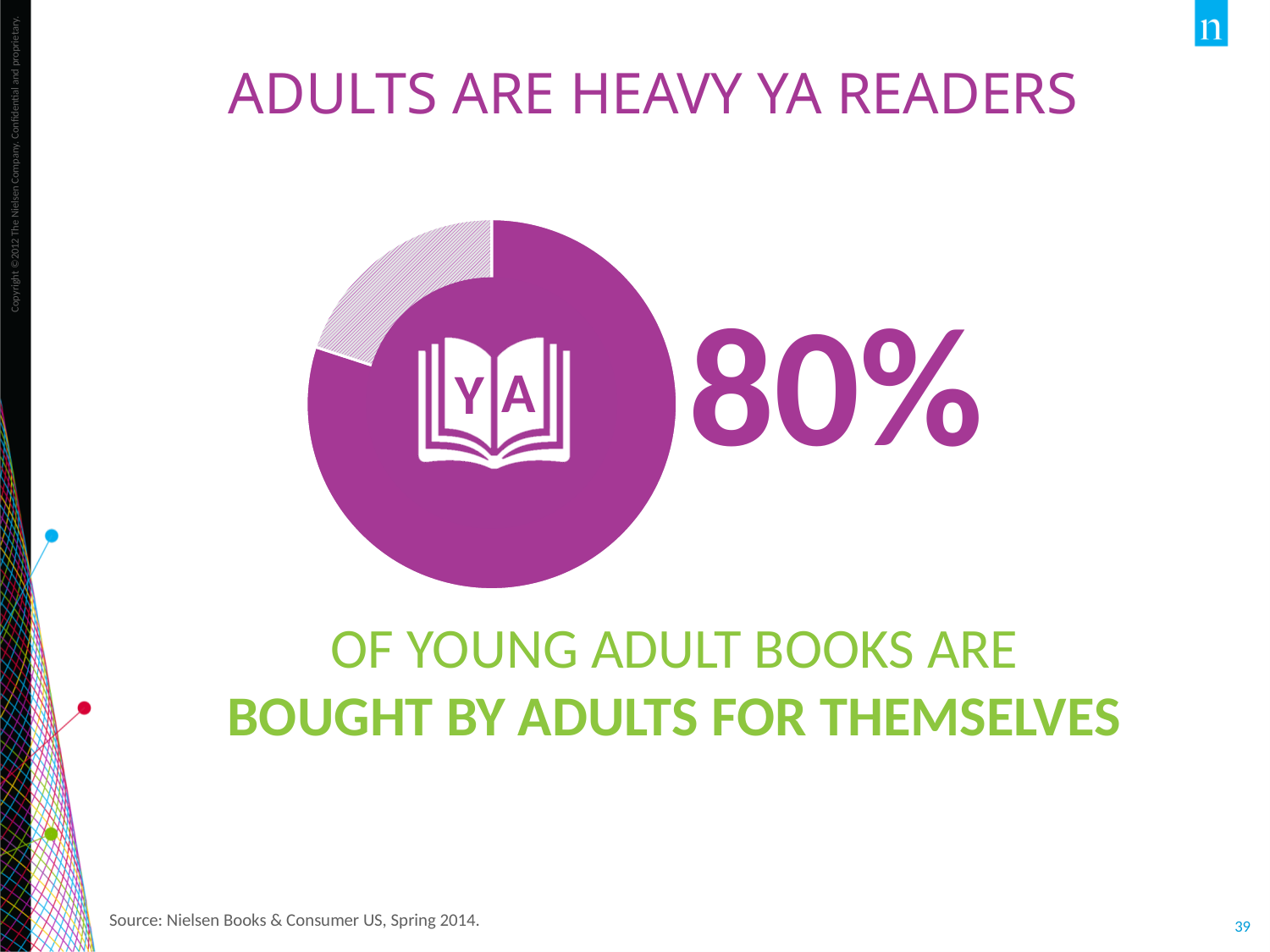
What kind of chart is shown on the slide? doughnut chart What source is cited for the chart data? Nielsen Books & Consumer US, Spring 2014. Which slice of the pie is larger, the solid purple slice or the hatched slice? the solid purple slice What is the title of the slide containing the chart? ADULTS ARE HEAVY YA READERS What percentage of young adult books are bought by adults for themselves, according to the chart? 80% Is the share of young adult books bought by adults for themselves greater or less than 50%? greater How many slices does the pie chart have? 2 What share of the pie does the hatched (striped) slice represent? 20%